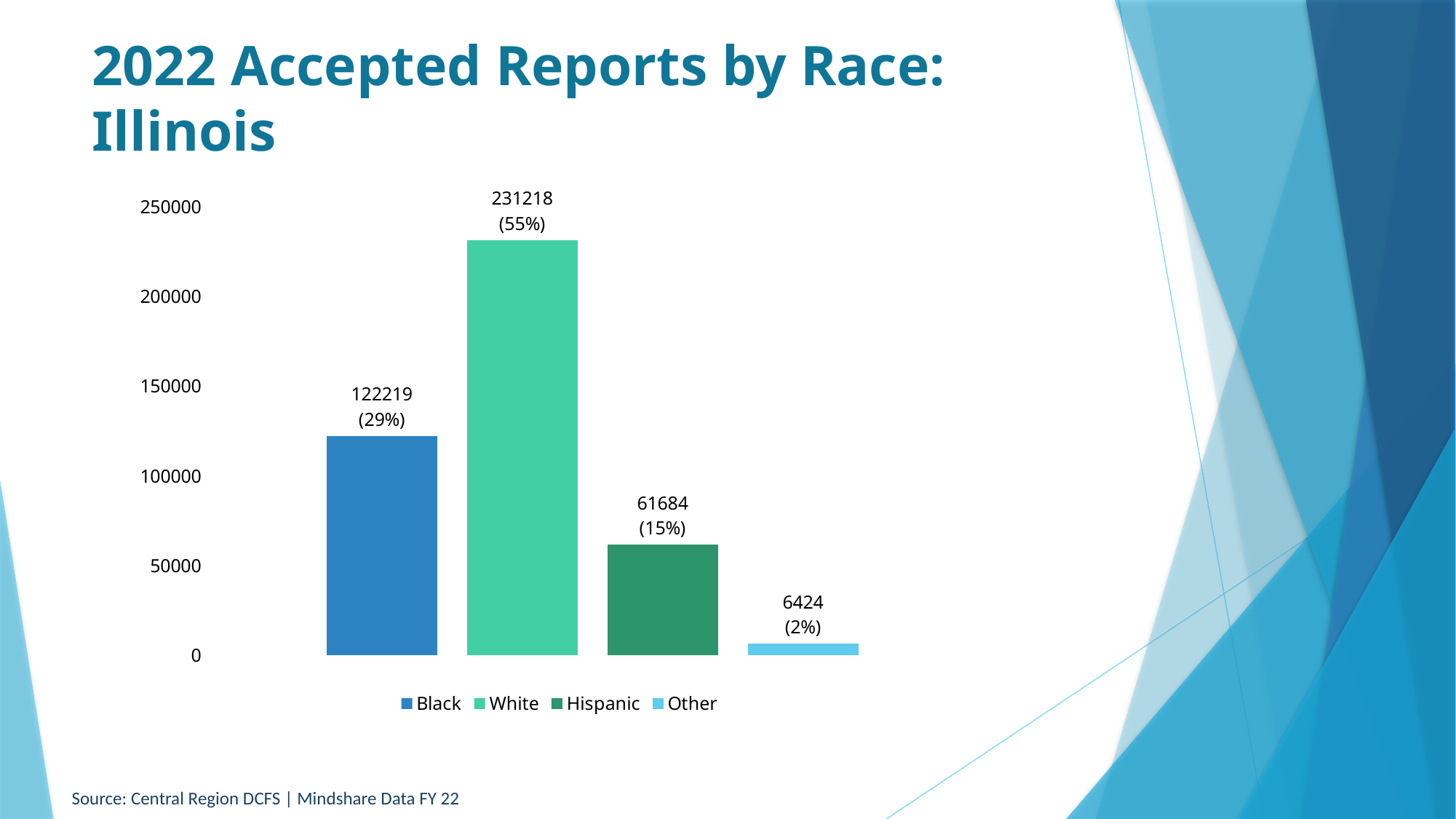
Is the value for Hispanic greater or less than 100000? less Which race category has the lowest number of accepted reports? Other Which has more accepted reports, Black or Hispanic? Black What is the number of accepted reports for Hispanic? 61684 How many race categories are shown in the chart? 4 Which race category has the highest number of accepted reports? White What is the difference between the accepted reports for White and Black? 108999 What percentage of accepted reports is shown for Other? 2% What is the title of the slide? 2022 Accepted Reports by Race: Illinois What is the number of accepted reports for Black? 122219 What is the number of accepted reports for White? 231218 What kind of chart is shown on the slide? Bar chart